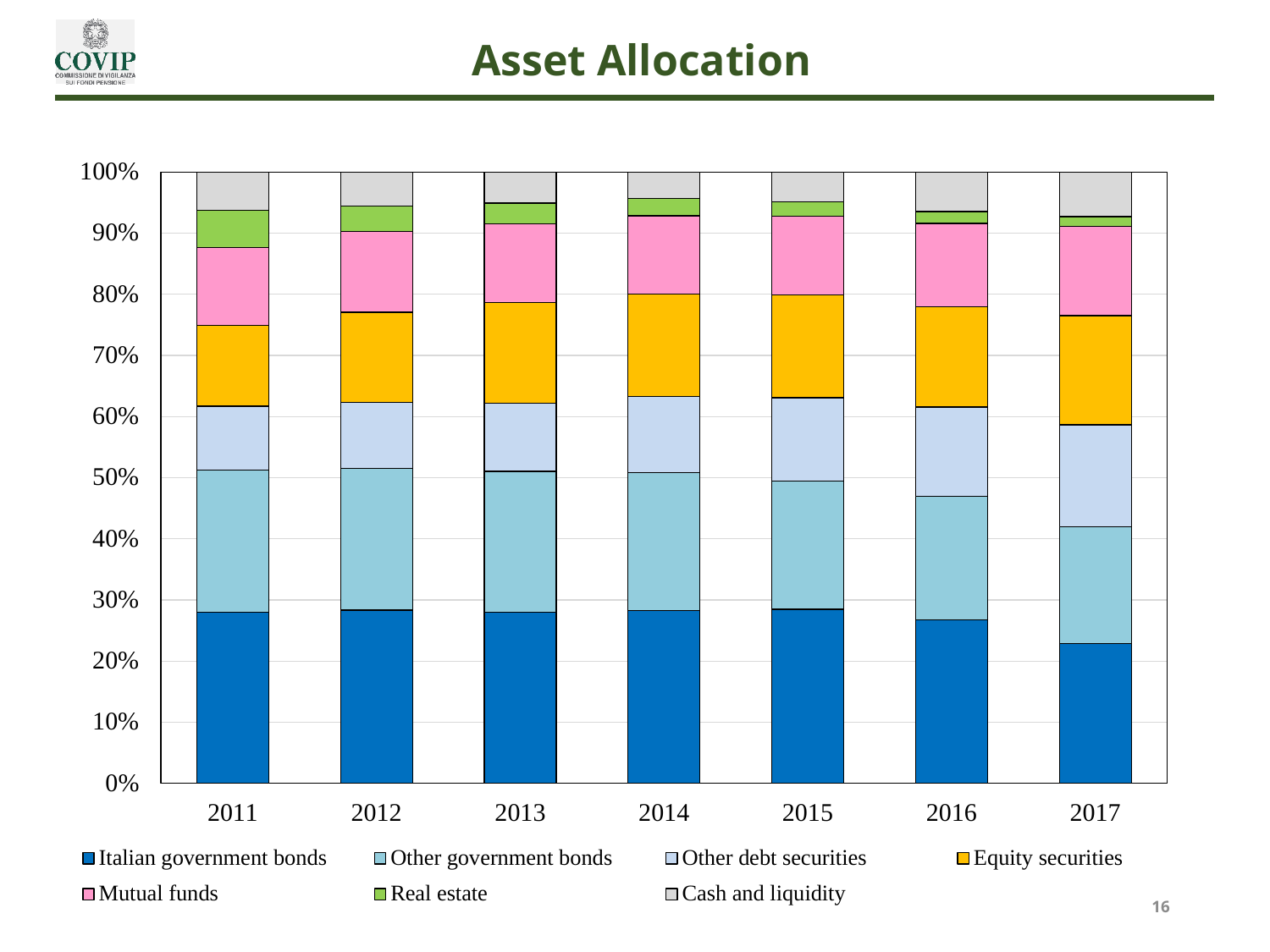
Is the share of Italian government bonds in 2017 greater or less than 30%? less Which series is shown in dark blue at the bottom of each bar? Italian government bonds How many years are shown on the x axis of the chart? 7 What is the title of the chart? Asset Allocation What kind of chart is shown on the slide? Stacked bar chart Is the Equity securities segment larger in 2011 or in 2017? 2017 Does the share of Italian government bonds rise or fall between 2015 and 2017? fall In which year is the Italian government bonds segment the smallest? 2017 How many series does the legend list? 7 In which year is the Real estate segment the largest? 2011 Is the share of Italian government bonds in 2017 greater or less than 20%? greater Is the Real estate segment larger in 2011 or in 2017? 2011